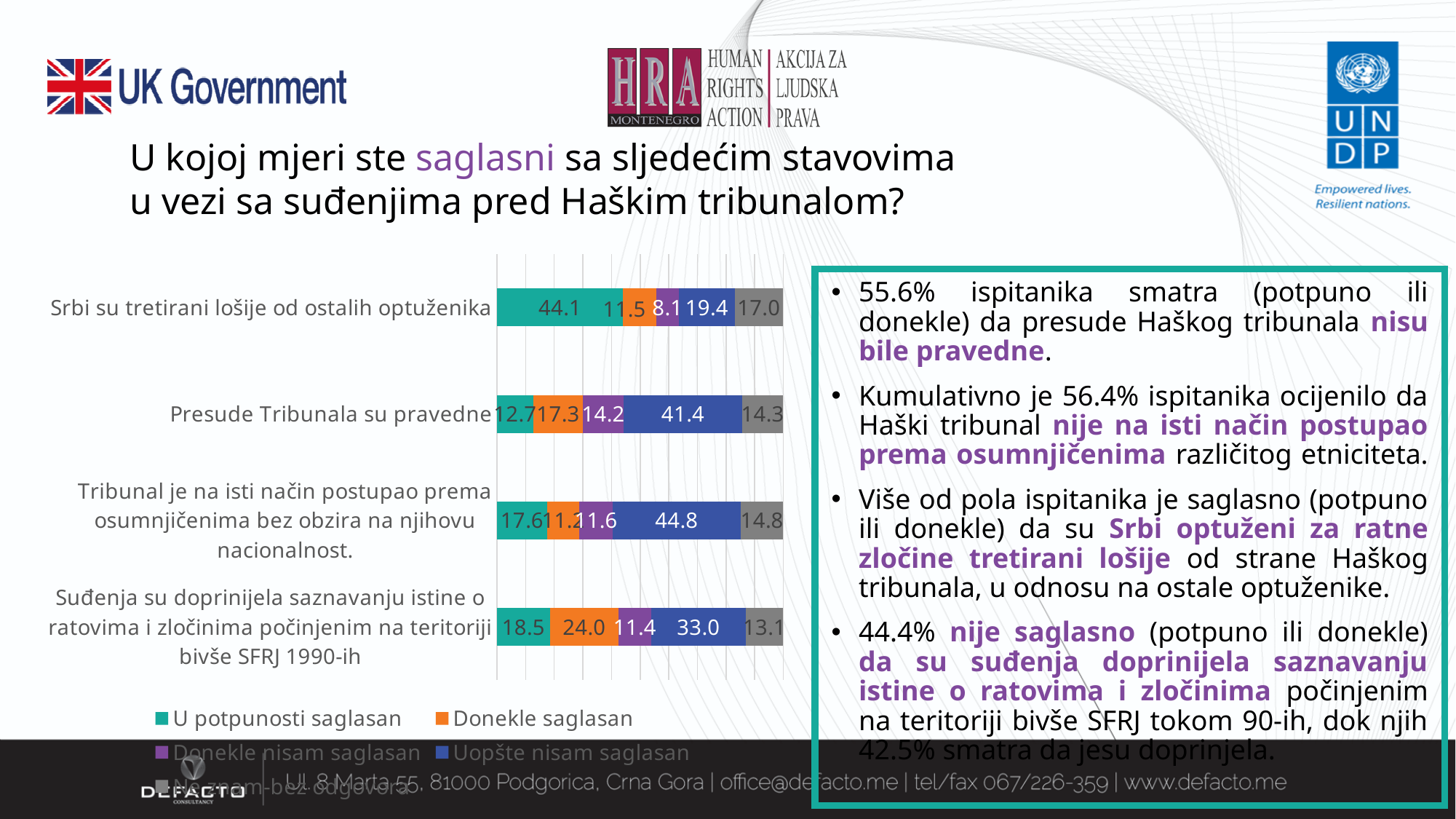
Which legend entry is shown in orange? Donekle saglasan What is the 'Uopšte nisam saglasan' value for 'Tribunal je na isti način postupao prema osumnjičenima bez obzira na njihovu nacionalnost.'? 44.8 What kind of chart is shown on the slide? Stacked bar chart What is the difference between the 'Uopšte nisam saglasan' values for 'Tribunal je na isti način postupao prema osumnjičenima bez obzira na njihovu nacionalnost.' and 'Suđenja su doprinijela saznavanju istine...'? 11.8 How many statements (categories) are shown in the chart? 4 What is the 'U potpunosti saglasan' value for 'Srbi su tretirani lošije od ostalih optuženika'? 44.1 What is the 'Uopšte nisam saglasan' value for 'Presude Tribunala su pravedne'? 41.4 Which statement has the highest 'U potpunosti saglasan' value? Srbi su tretirani lošije od ostalih optuženika Which statement has the lowest 'Uopšte nisam saglasan' value? Srbi su tretirani lošije od ostalih optuženika Which is larger: the 'U potpunosti saglasan' value for 'Presude Tribunala su pravedne' or for 'Suđenja su doprinijela saznavanju istine...'? Suđenja su doprinijela saznavanju istine... How many series does the legend list? 5 What is the 'Donekle saglasan' value for 'Suđenja su doprinijela saznavanju istine o ratovima i zločinima počinjenim na teritoriji bivše SFRJ 1990-ih'? 24.0